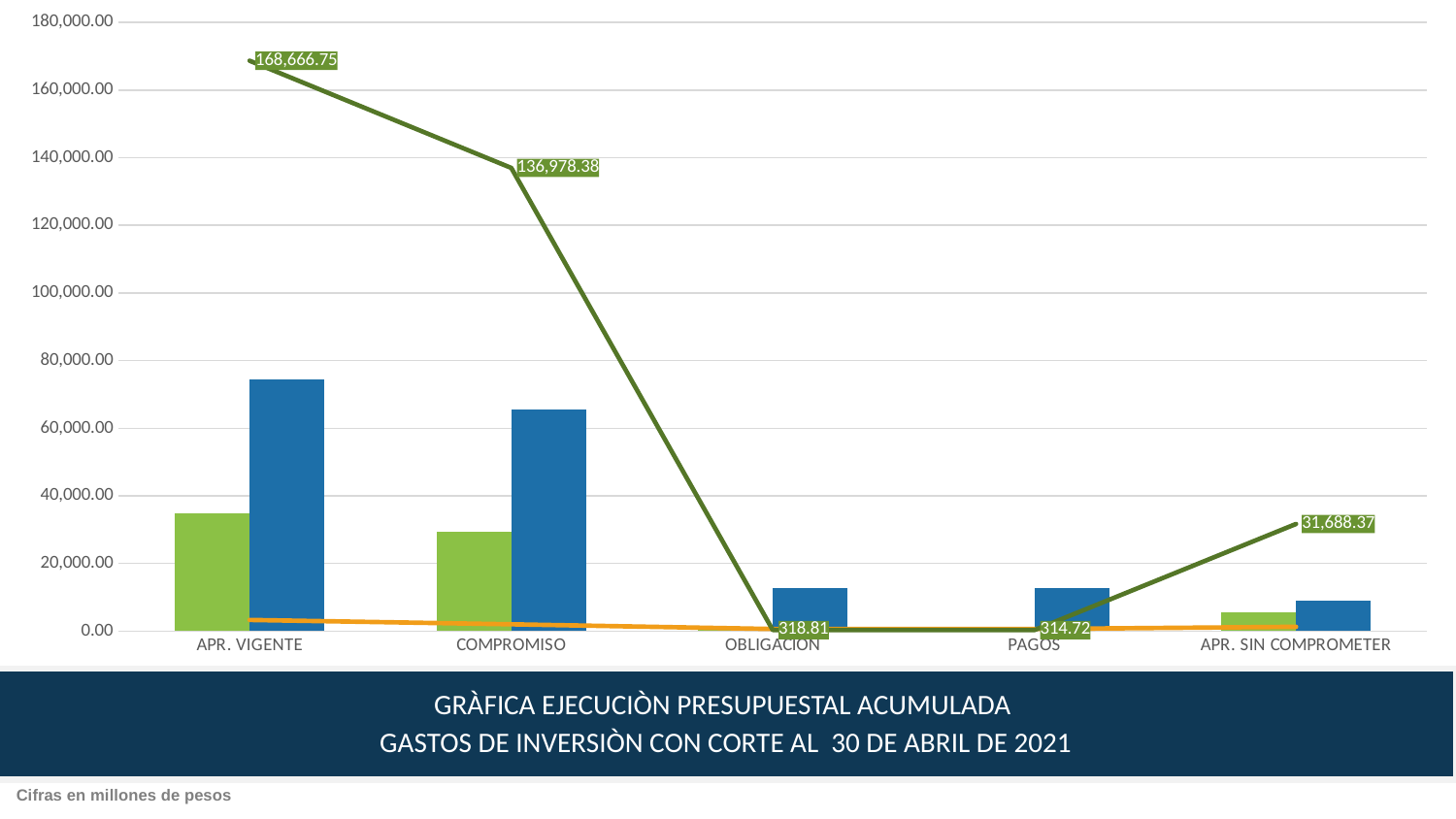
Which category has the lowest value on the dark green line? PAGOS What value does the dark green line show for APR. SIN COMPROMETER? 31,688.37 On the dark green line, which is larger: the value for OBLIGACION or the value for PAGOS? OBLIGACION How many categories are shown on the x axis? 5 What is the difference between the dark green line values for APR. VIGENTE and COMPROMISO? 31,688.37 Is the value of the blue bar for APR. VIGENTE greater or less than 60,000.00? greater What value does the dark green line show for PAGOS? 314.72 What value does the dark green line show for APR. VIGENTE? 168,666.75 Which category has the highest value on the dark green line? APR. VIGENTE What value does the dark green line show for COMPROMISO? 136,978.38 Is the value of the light green bar for APR. VIGENTE greater or less than 40,000.00? less What kind of chart is this? Combination bar and line chart